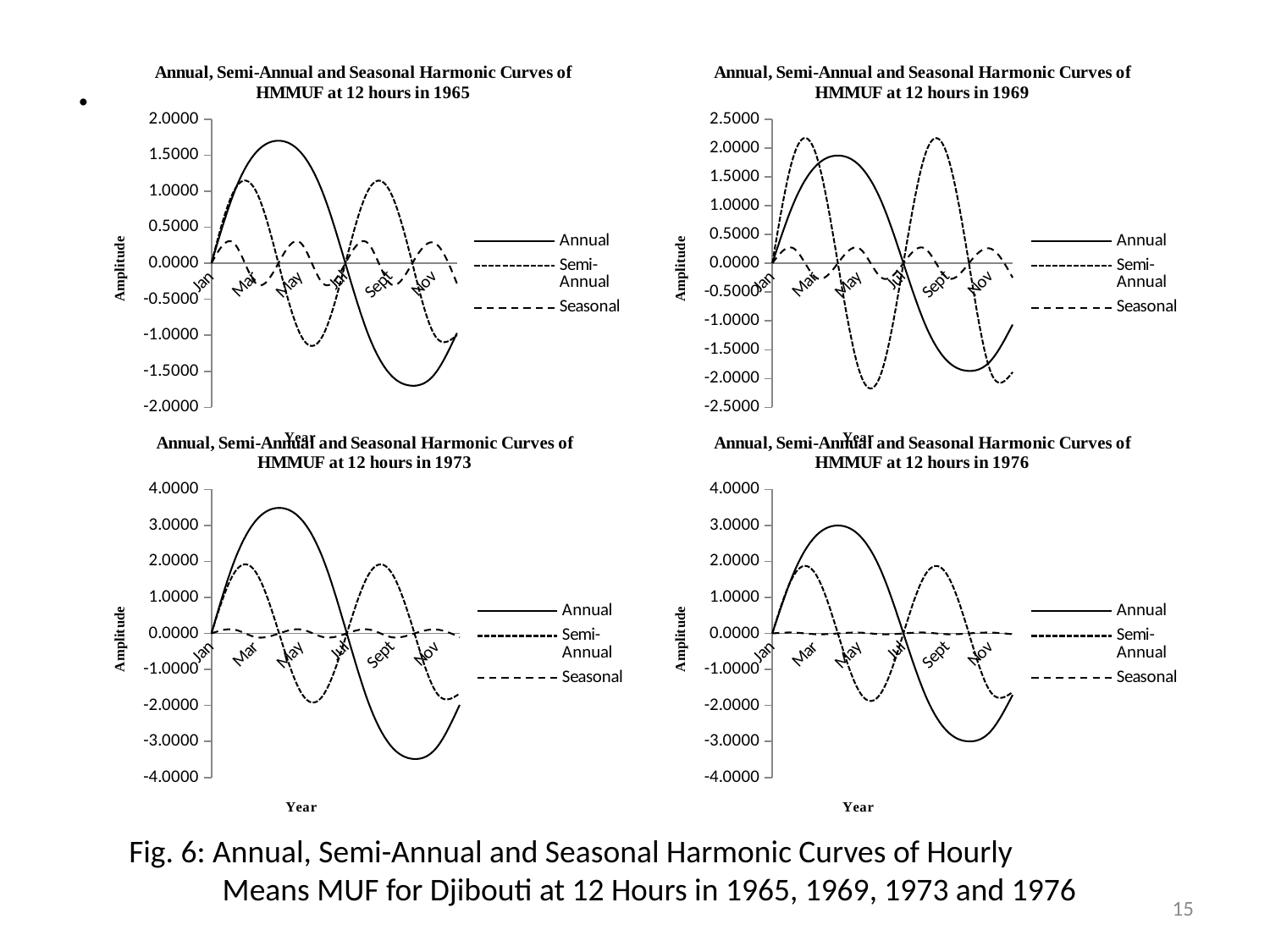
How many series does the legend list on the chart for 1969? 3 On the chart for 1965, is the peak value of the Annual curve greater or less than 1.5000? greater How many month labels are shown on the x axis of the chart for 1965? 6 What are the three series named in the legend of the chart for 1973? Annual, Semi-Annual, Seasonal On the chart for 1969, which curve reaches a higher peak, Annual or Semi-Annual? Semi-Annual What is the label on the vertical axis of the chart for 1976? Amplitude On the chart for 1976, is the peak value of the Annual curve greater or less than 2.0000? greater On the chart for 1973, is the peak value of the Annual curve greater or less than 3.0000? greater On the chart for 1973, which curve reaches a higher peak, Annual or Semi-Annual? Annual What kind of chart is the top-left chart, 'Annual, Semi-Annual and Seasonal Harmonic Curves of HMMUF at 12 hours in 1965'? Line chart On the chart for 1976, does the Annual curve rise or fall between Jan and Mar? Rise